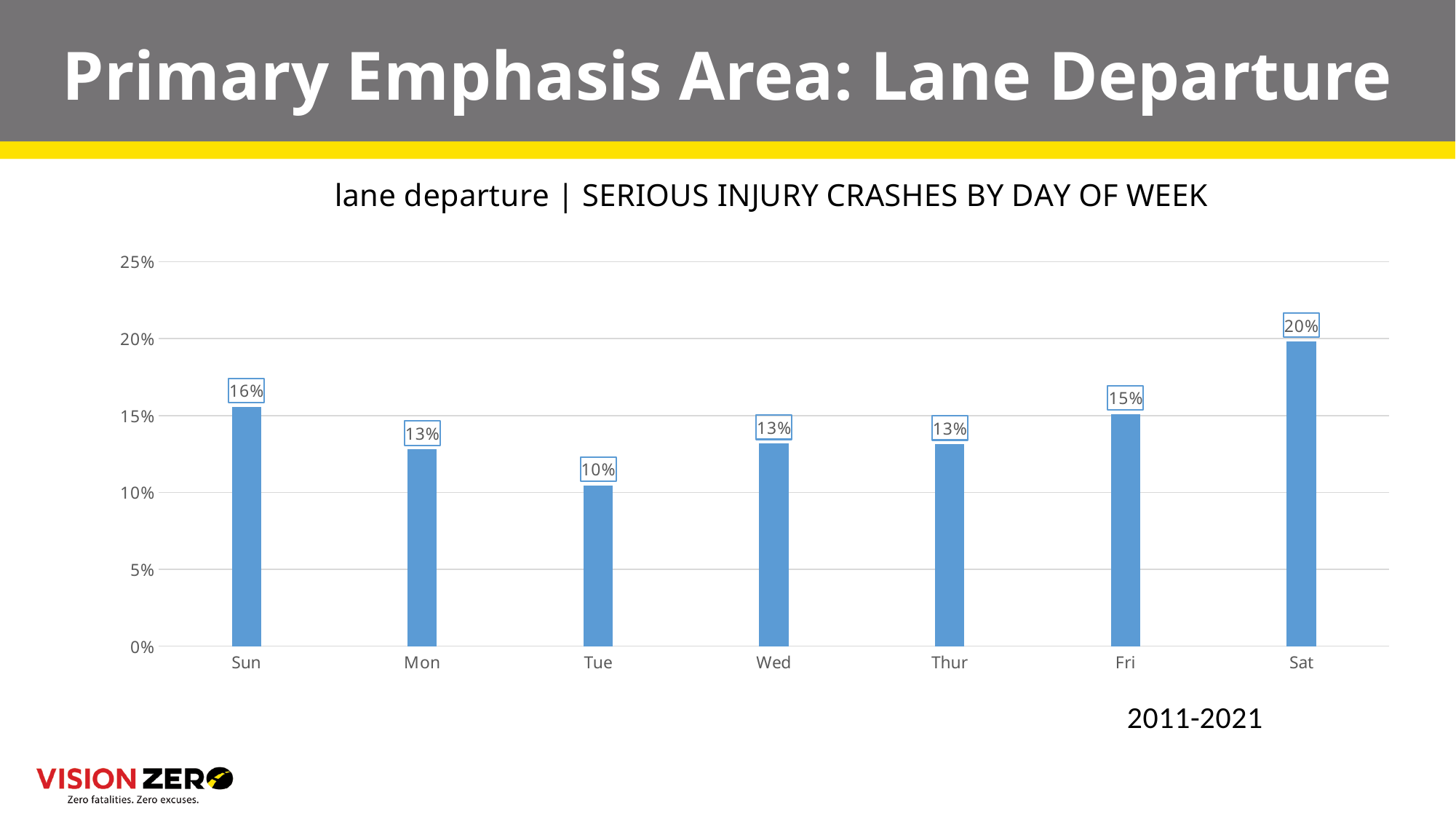
What is the title of the chart? lane departure | SERIOUS INJURY CRASHES BY DAY OF WEEK What is the difference between the values for Sat and Tue? 10% What kind of chart is shown on the slide? Bar chart Which day has the highest share of serious injury crashes? Sat Which day has the lowest share of serious injury crashes? Tue Is the value for Sat greater or less than 15%? greater What is the value for Tue? 10% What is the value for Sat? 20% Which is larger, the value for Sun or the value for Fri? Sun How many days of the week are shown on the x axis? 7 What is the value for Fri? 15% What is the value for Sun? 16%